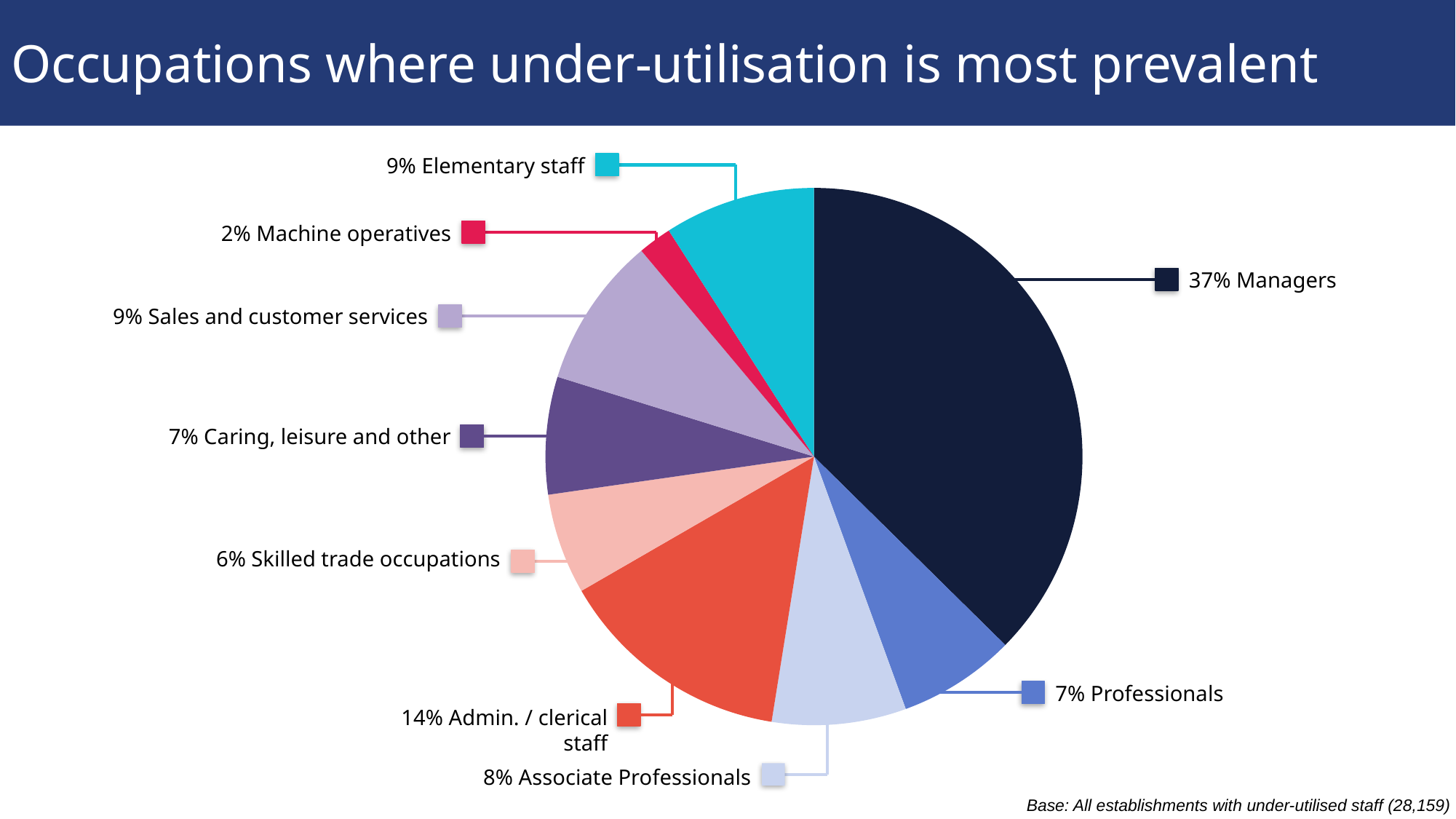
Which occupation has the smallest slice? Machine operatives What is the value for Admin. / clerical staff? 14% How many slices does the pie chart have? 9 Which is larger, Associate Professionals or Skilled trade occupations? Associate Professionals What is the value for Sales and customer services? 9% What is the value for Machine operatives? 2% What share of the pie is Managers? 37% What is the base stated for the chart? All establishments with under-utilised staff (28,159) What is the difference between Managers and Admin. / clerical staff? 23% What is the title of the slide? Occupations where under-utilisation is most prevalent What kind of chart is shown on the slide? Pie chart Which occupation has the largest slice? Managers